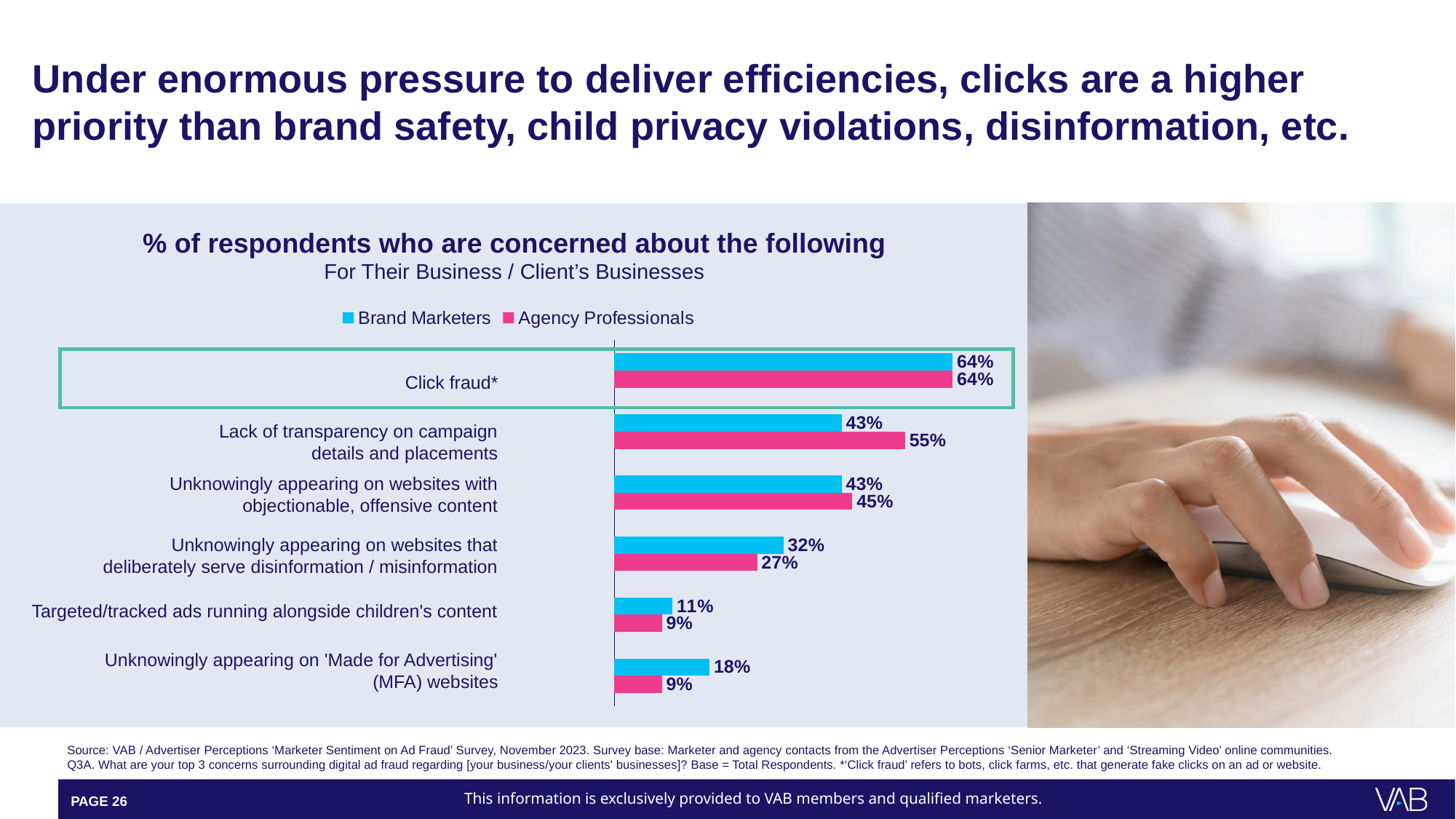
Which concern has the highest percentage among Agency Professionals? Click fraud* What is the difference between Agency Professionals and Brand Marketers for lack of transparency on campaign details and placements? 12 percentage points What percentage of Agency Professionals are concerned about lack of transparency on campaign details and placements? 55% For unknowingly appearing on websites that deliberately serve disinformation / misinformation, which group has the higher percentage? Brand Marketers What is the subtitle of the chart? For Their Business / Client's Businesses How many series does the legend list? 2 What percentage of Agency Professionals are concerned about targeted/tracked ads running alongside children's content? 9% Which concern has the lowest percentage among Brand Marketers? Targeted/tracked ads running alongside children's content What percentage of Brand Marketers are concerned about click fraud? 64% How many concern categories are shown in the chart? 6 What type of chart is shown on the slide? Bar chart What percentage of Brand Marketers are concerned about unknowingly appearing on 'Made for Advertising' (MFA) websites? 18%